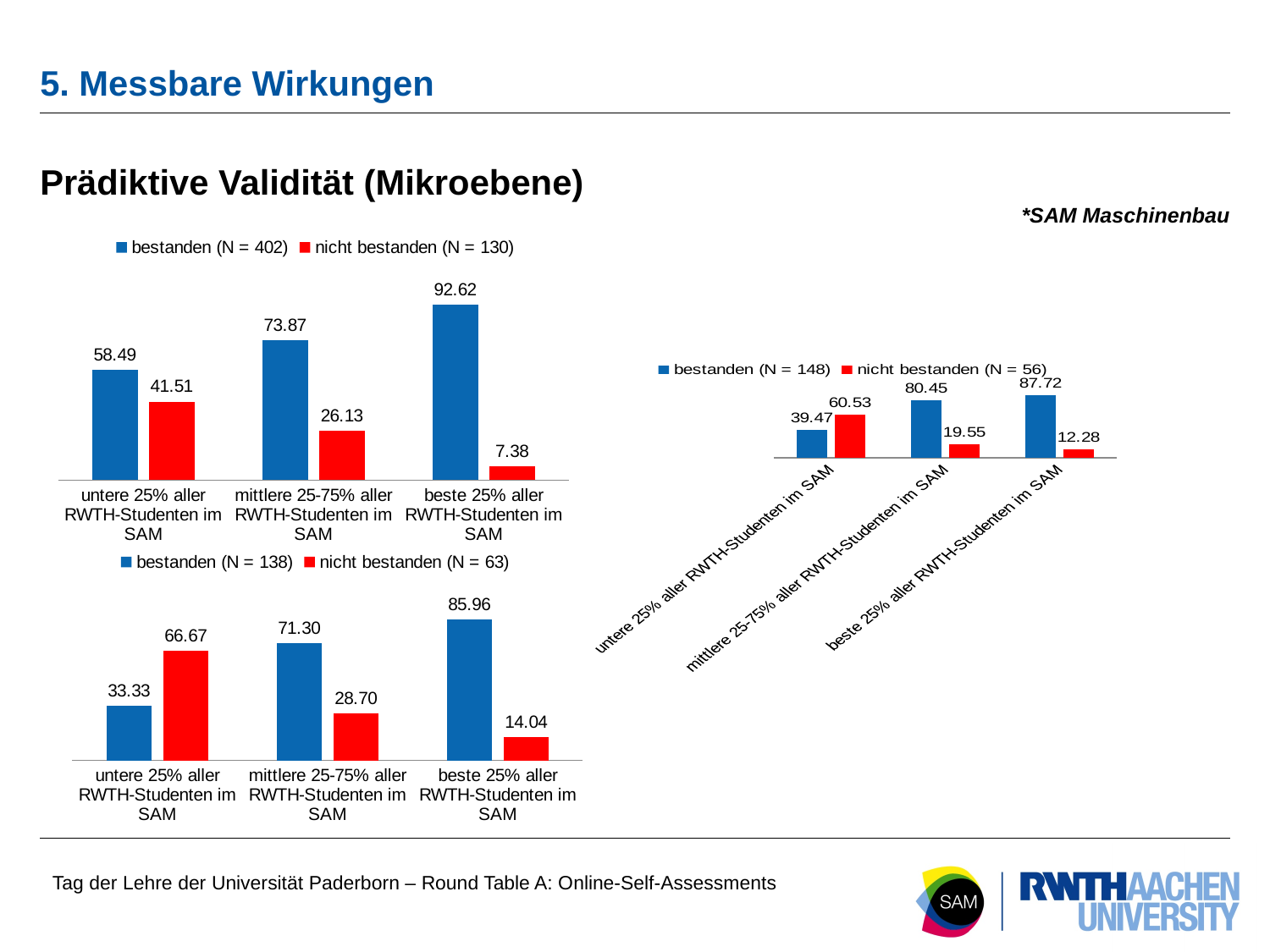
In the right-hand chart (bestanden N = 148), what is the value for 'bestanden' in the 'mittlere 25-75% aller RWTH-Studenten im SAM' category? 80.45 In the bottom-left chart (bestanden N = 138), what is the value for 'nicht bestanden' in the 'untere 25% aller RWTH-Studenten im SAM' category? 66.67 In the right-hand chart (bestanden N = 148), what is the value for 'nicht bestanden' in the 'beste 25% aller RWTH-Studenten im SAM' category? 12.28 In the top-left chart (bestanden N = 402), what is the difference between the 'bestanden' and 'nicht bestanden' values for 'untere 25% aller RWTH-Studenten im SAM'? 16.98 In the top-left chart (bestanden N = 402), what is the value for 'bestanden' in the 'beste 25% aller RWTH-Studenten im SAM' category? 92.62 What kind of chart is the top-left chart (bestanden N = 402)? bar chart How many series does the legend of the right-hand chart (bestanden N = 148) list? 2 In the bottom-left chart (bestanden N = 138), do the 'bestanden' values rise or fall from the 'untere 25%' category to the 'beste 25%' category? rise In the bottom-left chart (bestanden N = 138), which is larger for 'untere 25% aller RWTH-Studenten im SAM': 'bestanden' or 'nicht bestanden'? nicht bestanden In the top-left chart (bestanden N = 402), which category has the lowest 'nicht bestanden' value? beste 25% aller RWTH-Studenten im SAM In the top-left chart (bestanden N = 402), what is the value for 'nicht bestanden' in the 'mittlere 25-75% aller RWTH-Studenten im SAM' category? 26.13 In the bottom-left chart (bestanden N = 138), which category has the highest 'bestanden' value? beste 25% aller RWTH-Studenten im SAM